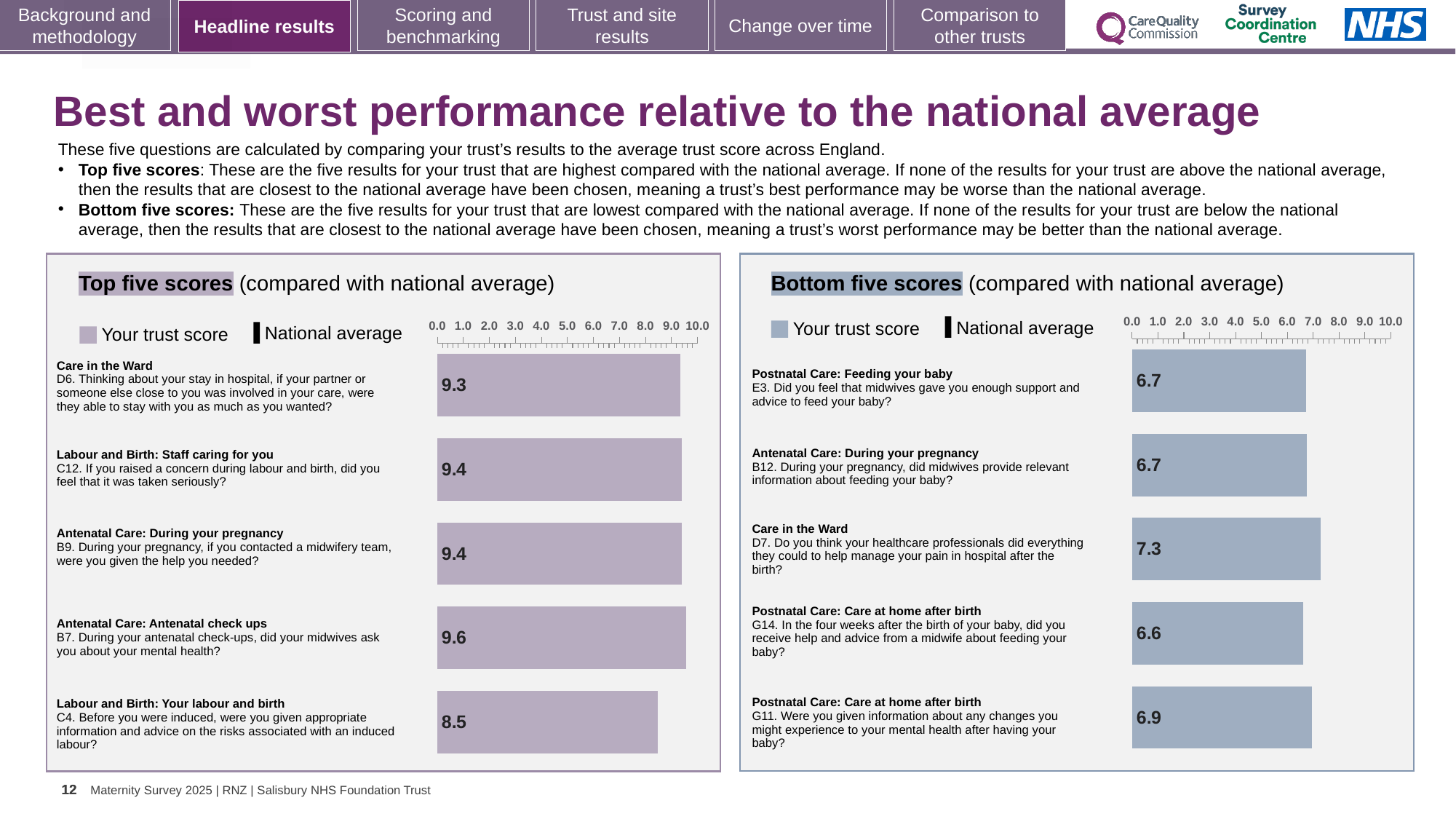
In the Bottom five scores chart, what is the trust score for question D7 (Care in the Ward)? 7.3 How many bars are plotted in the Bottom five scores chart? 5 In the Top five scores chart, what is the trust score for question D6 (Care in the Ward)? 9.3 In the Bottom five scores chart, which question has the lowest trust score? G14 (Postnatal Care: Care at home after birth), 6.6 In the Top five scores chart, what is the trust score for question B7 about antenatal check-ups and mental health? 9.6 In the Top five scores chart, which question has the lowest trust score? C4 (Labour and Birth: Your labour and birth), 8.5 What kind of chart is used in the Top five scores panel? Bar chart In the Top five scores chart, what is the difference between the scores for B7 and C4? 1.1 In the Bottom five scores chart, what is the difference between the scores for D7 and G14? 0.7 In the Top five scores chart, which question has the highest trust score? B7 (Antenatal Care: Antenatal check ups), 9.6 In the Top five scores chart, which has the larger score: C12 or C4? C12 (9.4) In the Bottom five scores chart, is the value for question E3 greater or less than 7.0? less